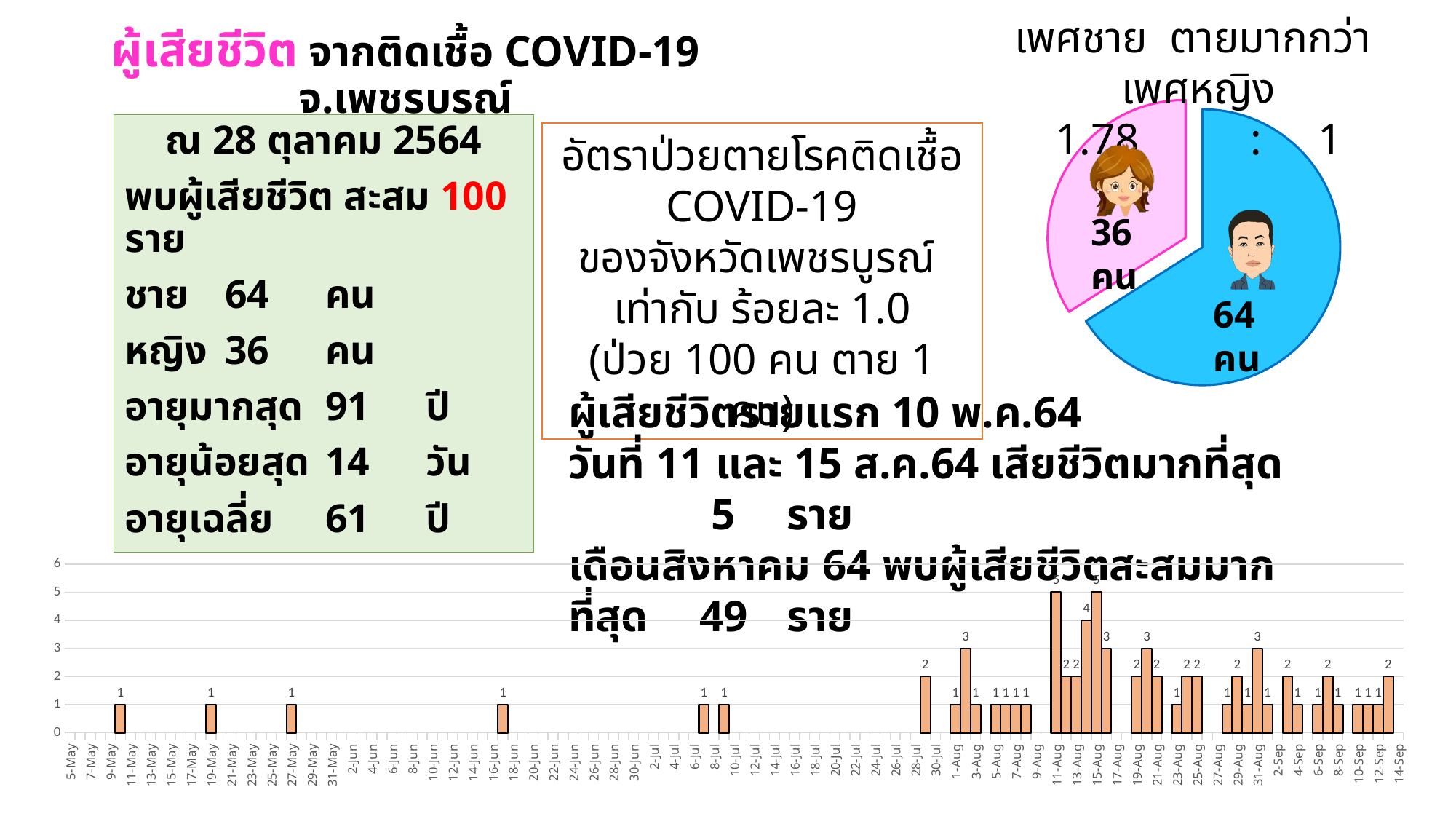
In the pie chart, which slice is larger, the blue (male) slice or the pink (female) slice? blue (male) In the pie chart, what share of the total do the 64 male deaths represent? 64% In the pie chart, what is the difference between the male value (64) and the female value (36)? 28 In the bar chart at the bottom, do the daily values generally rise or fall from May to August? rise In the bar chart at the bottom, what is the highest daily value shown? 5 What kind of chart is the chart at the bottom of the slide? bar chart In the bar chart at the bottom, what is the highest value shown on the vertical axis? 6 What kind of chart is the chart in the top right of the slide? pie chart In the pie chart, what is the value shown for the blue (male) slice? 64 คน In the pie chart, what is the value shown for the pink (female) slice? 36 คน In the pie chart, how many slices are there? 2